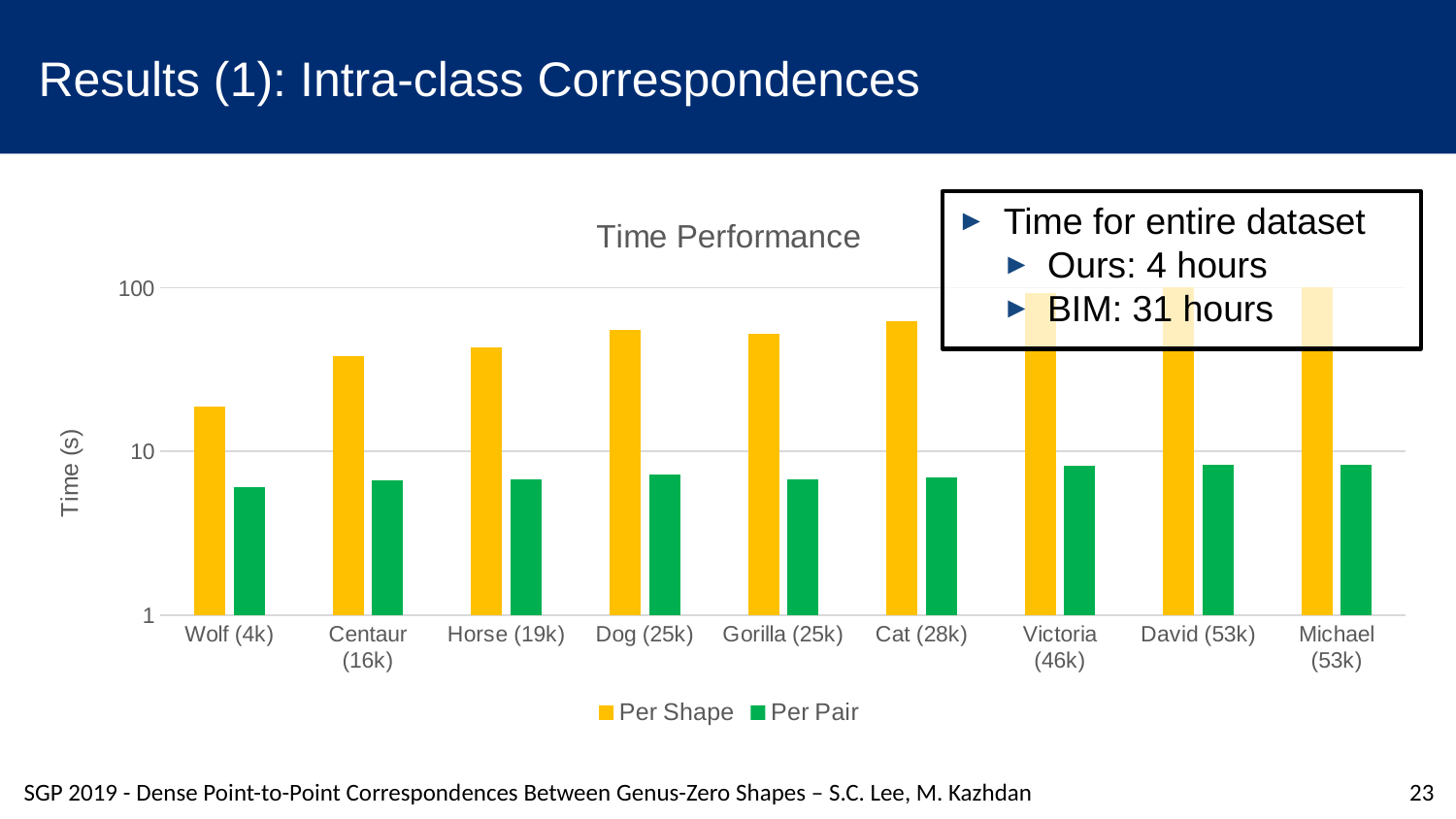
For Dog (25k), which is larger: the Per Shape time or the Per Pair time? Per Shape What is the title of the chart? Time Performance Is the Per Pair value for Wolf (4k) greater or less than 10? less How many shape categories are shown along the x axis of the chart? 9 How many series does the chart's legend list? 2 Is the Per Shape value for Cat (28k) greater or less than 100? less Which category has the lowest Per Shape time? Wolf (4k) What is the label on the y axis of the chart? Time (s) What kind of chart is shown on the slide? bar chart Is the Per Shape value for Wolf (4k) greater or less than 10? greater Do the Per Shape values generally rise or fall from Wolf (4k) to Michael (53k)? rise